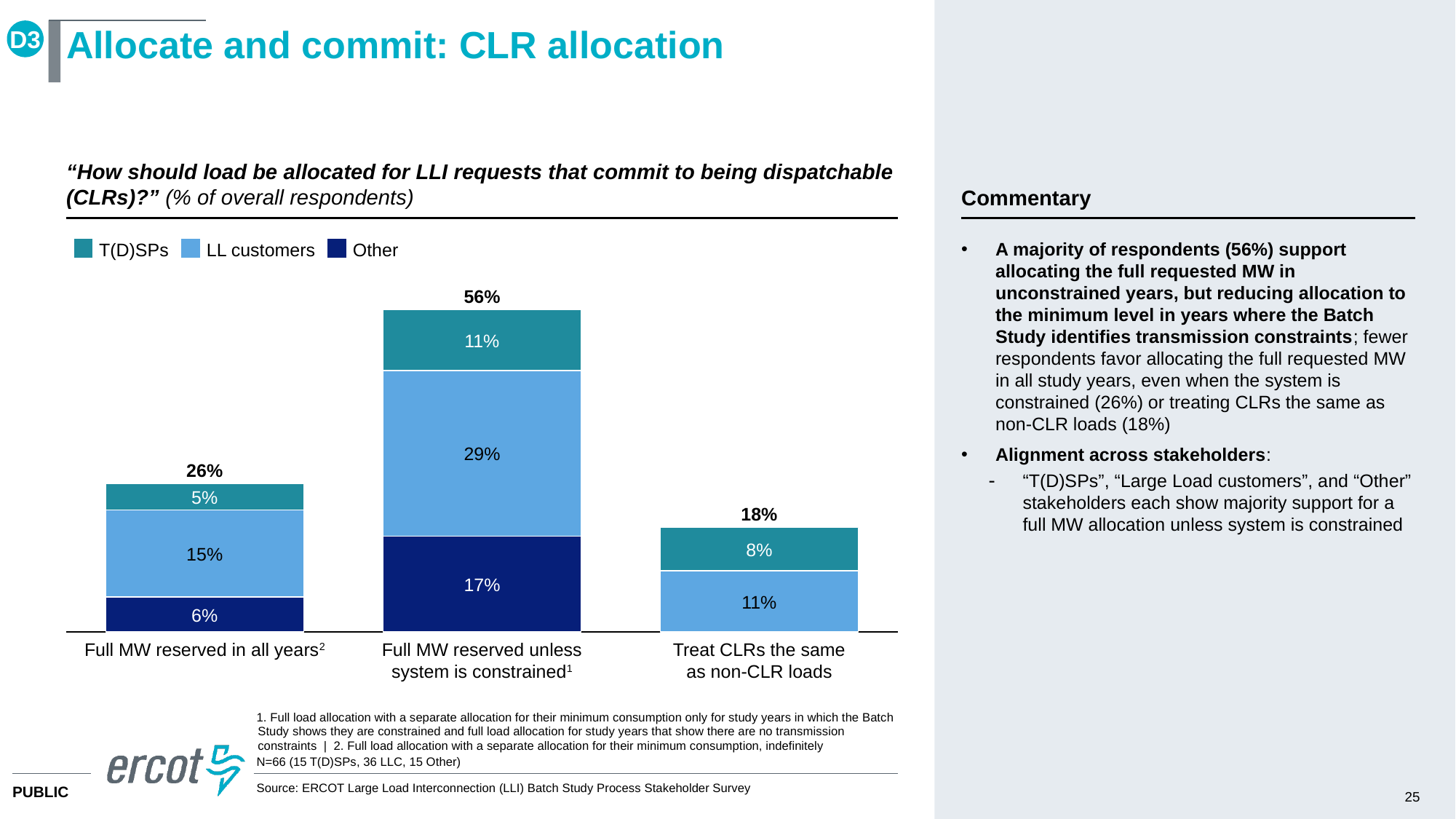
Which is larger: the LL customers value for "Full MW reserved in all years" or the LL customers value for "Treat CLRs the same as non-CLR loads"? Full MW reserved in all years What is the difference between the total for "Full MW reserved unless system is constrained" and the total for "Full MW reserved in all years"? 30% How many series does the chart legend list? 3 What is the LL customers value for "Full MW reserved unless system is constrained"? 29% What is the total share of respondents for "Full MW reserved unless system is constrained"? 56% Which category has the highest total share of respondents? Full MW reserved unless system is constrained What is the T(D)SPs value for "Treat CLRs the same as non-CLR loads"? 8% What is the Other value for "Full MW reserved in all years"? 6% Which category has the lowest total share of respondents? Treat CLRs the same as non-CLR loads How many categories are shown on the x axis of the chart? 3 What is the total share of respondents for "Full MW reserved in all years"? 26% What kind of chart is shown on the slide? Stacked bar chart